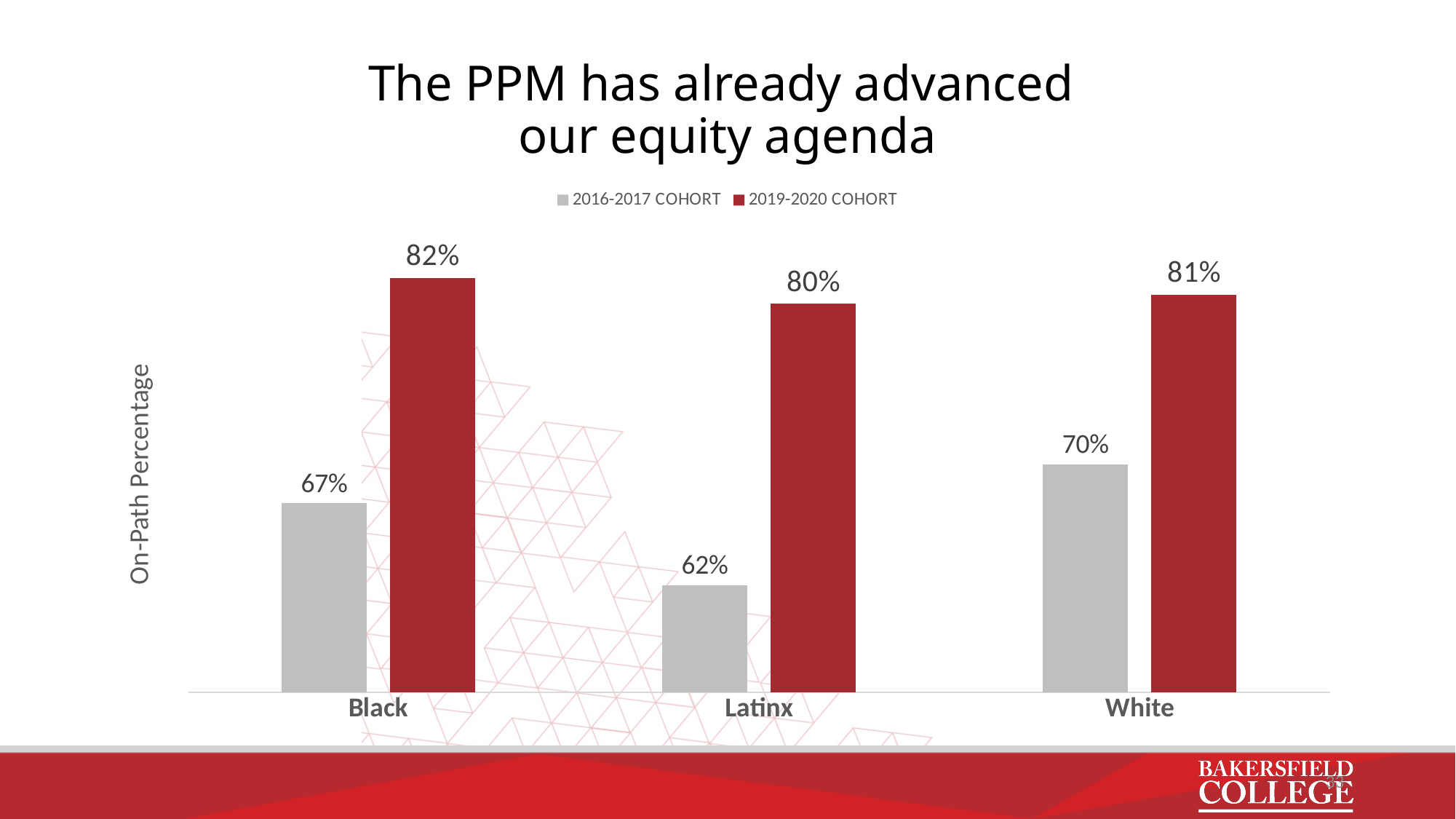
What is the on-path percentage for Latinx students in the 2019-2020 cohort? 80% What is the difference between the 2019-2020 and 2016-2017 cohort on-path percentages for Black students? 15% What is the on-path percentage for Black students in the 2016-2017 cohort? 67% How many series does the legend list? 2 How many groups are shown on the x axis? 3 Which group has the lowest on-path percentage in the 2016-2017 cohort? Latinx What is the on-path percentage for White students in the 2016-2017 cohort? 70% Which is larger: the 2016-2017 cohort value for Black students or for Latinx students? Black Which group has the highest on-path percentage in the 2016-2017 cohort? White What is the label on the vertical axis? On-Path Percentage What is the difference between the 2019-2020 and 2016-2017 cohort on-path percentages for Latinx students? 18% What kind of chart is shown on the slide? Bar chart